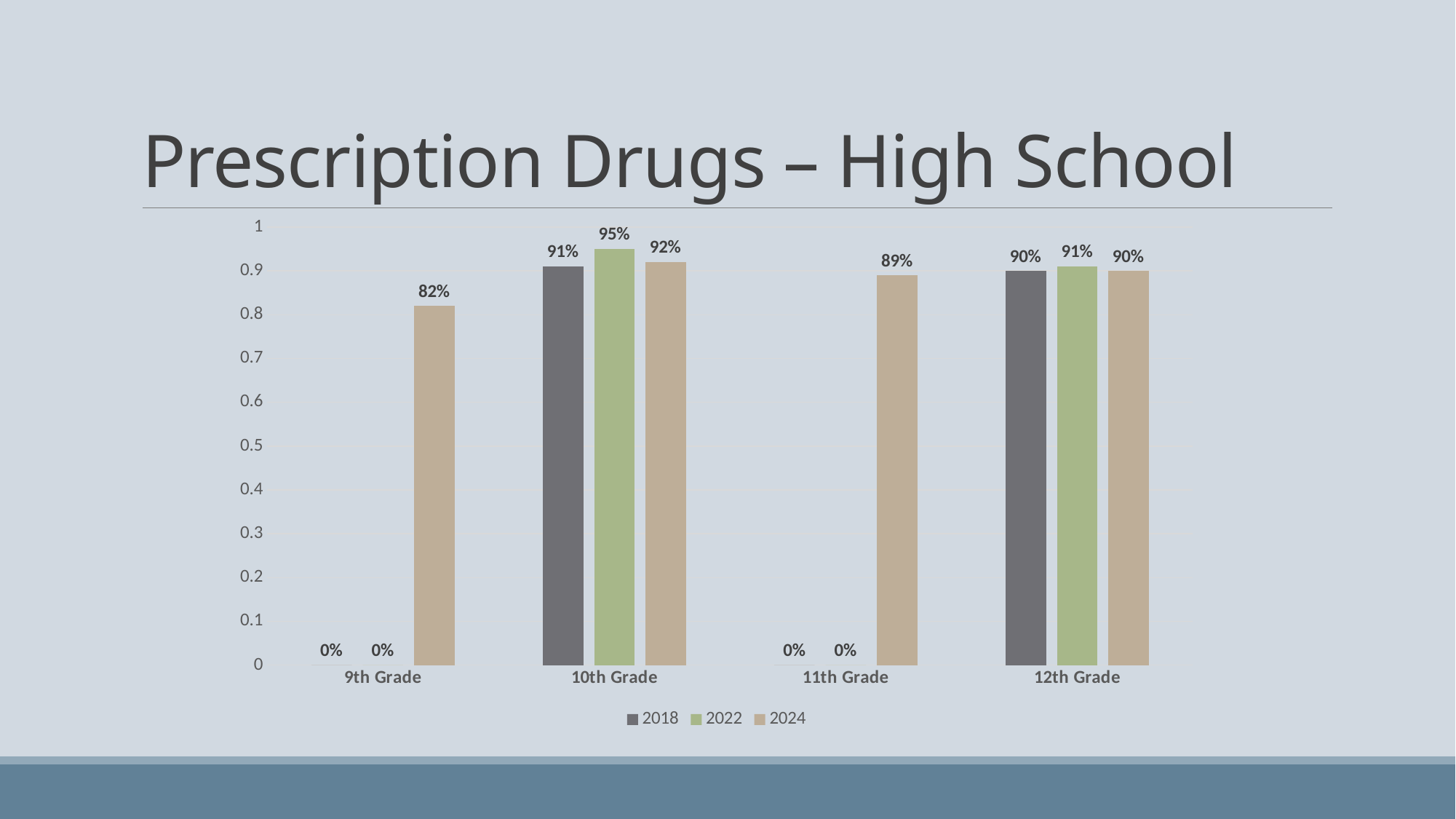
How many series does the legend list? 3 What is the value for 2024 in 11th Grade? 89% Which is larger, the 2024 value for 10th Grade or the 2024 value for 12th Grade? 10th Grade What is the value for 2018 in 12th Grade? 90% What is the value for 2022 in 10th Grade? 95% Which grade has the lowest 2024 value? 9th Grade What kind of chart is shown on the slide? Bar chart Which grade has the highest 2024 value? 10th Grade What is the value for 2024 in 9th Grade? 82% What is the title of the slide? Prescription Drugs – High School What is the difference between the 2022 and 2018 values for 10th Grade? 4% How many grade categories are shown on the x axis? 4